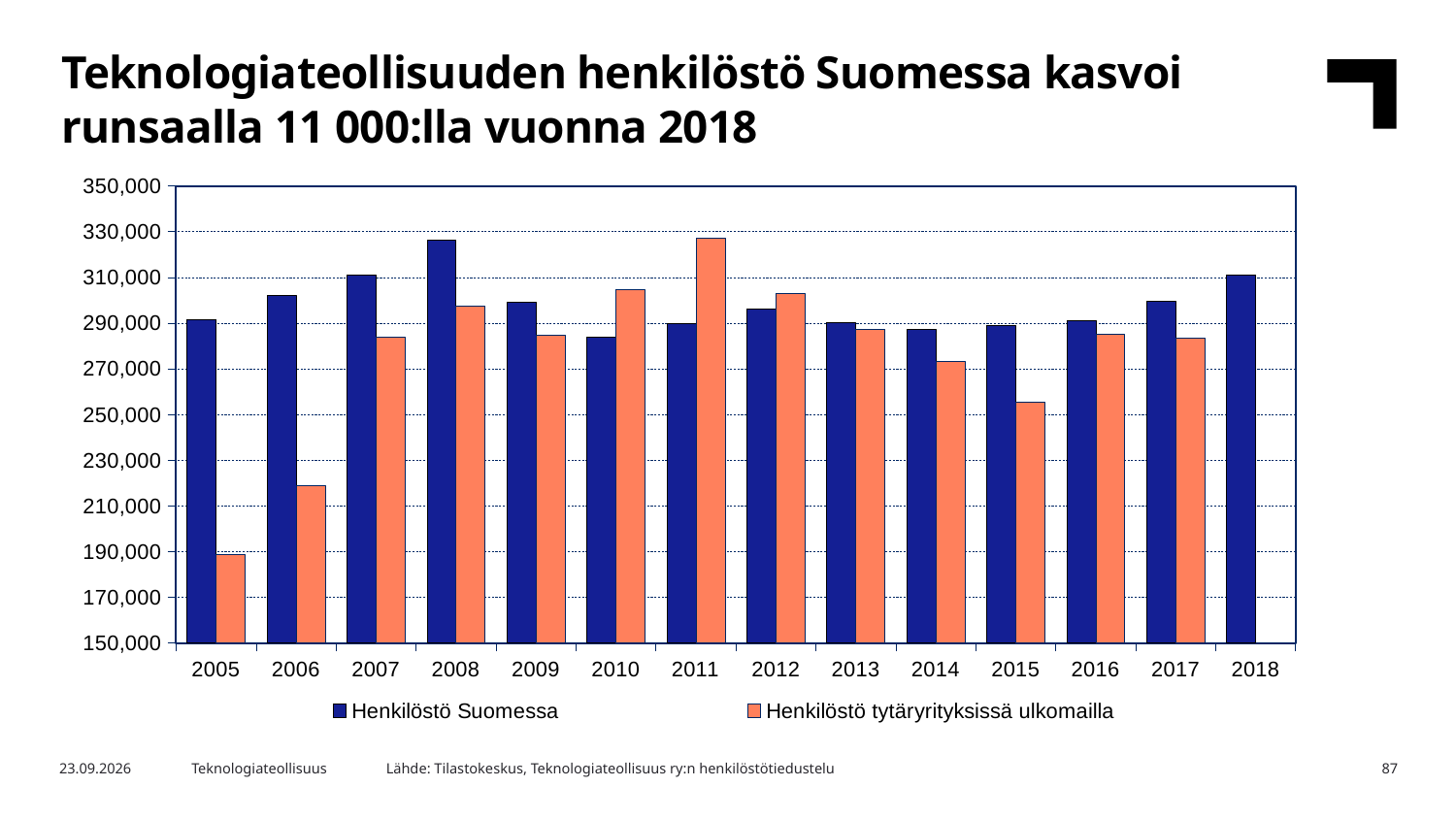
Is the value for Henkilöstö tytäryrityksissä ulkomailla in 2006 greater or less than 230,000? less Which year has the lowest value for Henkilöstö tytäryrityksissä ulkomailla? 2005 Which year has the highest value for Henkilöstö tytäryrityksissä ulkomailla? 2011 Is the value for Henkilöstö Suomessa in 2008 greater or less than 310,000? greater Does the value for Henkilöstö tytäryrityksissä ulkomailla rise or fall from 2011 to 2015? fall In 2011, which is larger: Henkilöstö Suomessa or Henkilöstö tytäryrityksissä ulkomailla? Henkilöstö tytäryrityksissä ulkomailla In 2015, which is larger: Henkilöstö Suomessa or Henkilöstö tytäryrityksissä ulkomailla? Henkilöstö Suomessa What kind of chart is shown on the slide? bar chart How many series does the chart legend list? 2 Which year in the chart shows only the Henkilöstö Suomessa bar and no bar for Henkilöstö tytäryrityksissä ulkomailla? 2018 How many years are shown on the x axis of the chart? 14 Which year has the highest value for Henkilöstö Suomessa? 2008